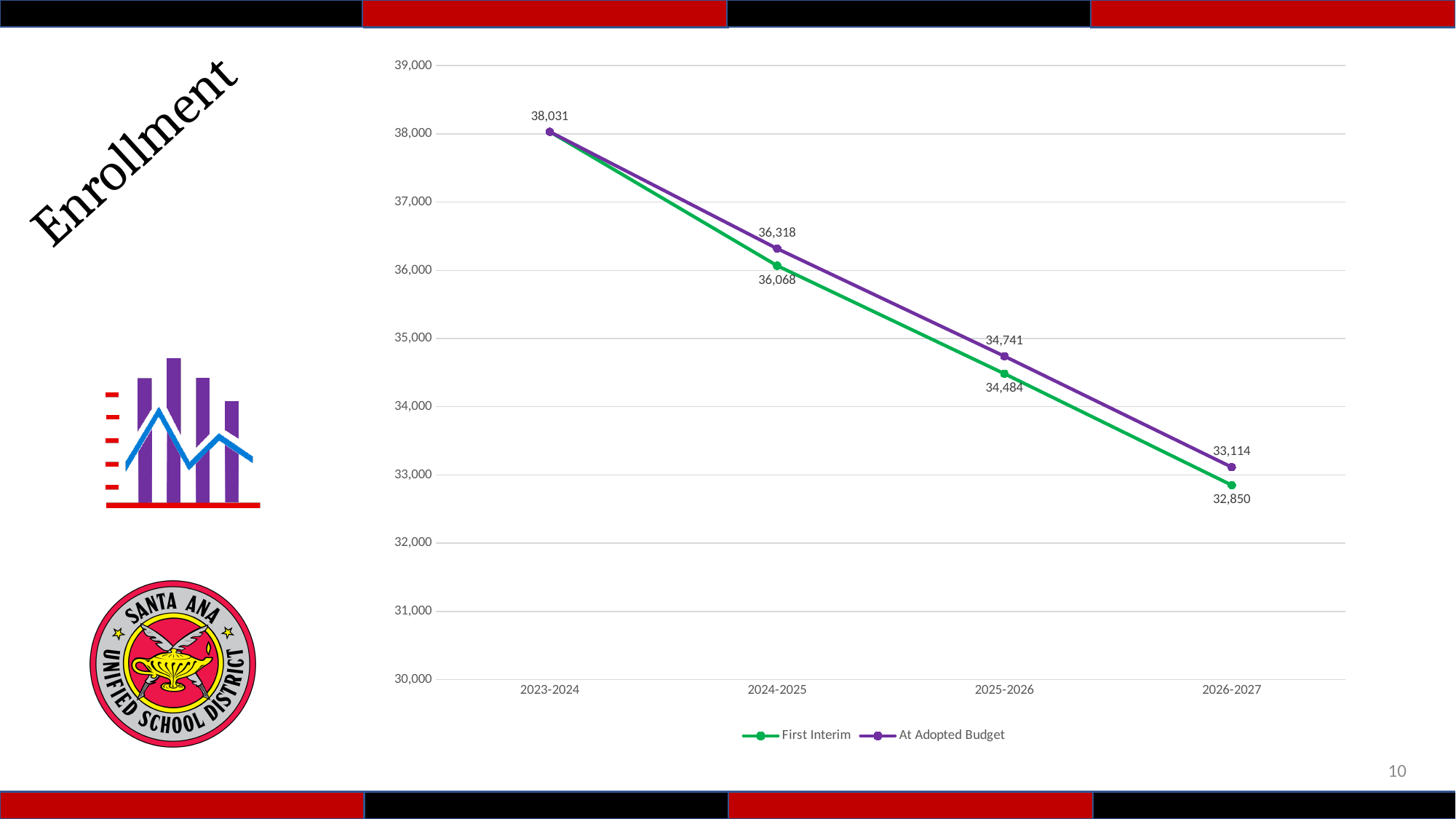
How many series does the legend list? 2 What is the difference between the At Adopted Budget and First Interim values for 2026-2027? 264 How many school years are shown on the x axis? 4 Which series is drawn in green? First Interim What is the enrollment value shown for 2023-2024? 38,031 What type of chart is shown on the slide? Line chart What is the difference between the At Adopted Budget and First Interim values for 2024-2025? 250 What is the At Adopted Budget enrollment value for 2025-2026? 34,741 What is the First Interim enrollment value for 2026-2027? 32,850 Which school year has the lowest First Interim enrollment? 2026-2027 What is the At Adopted Budget enrollment value for 2024-2025? 36,318 Do enrollment values rise or fall from 2023-2024 to 2026-2027? Fall